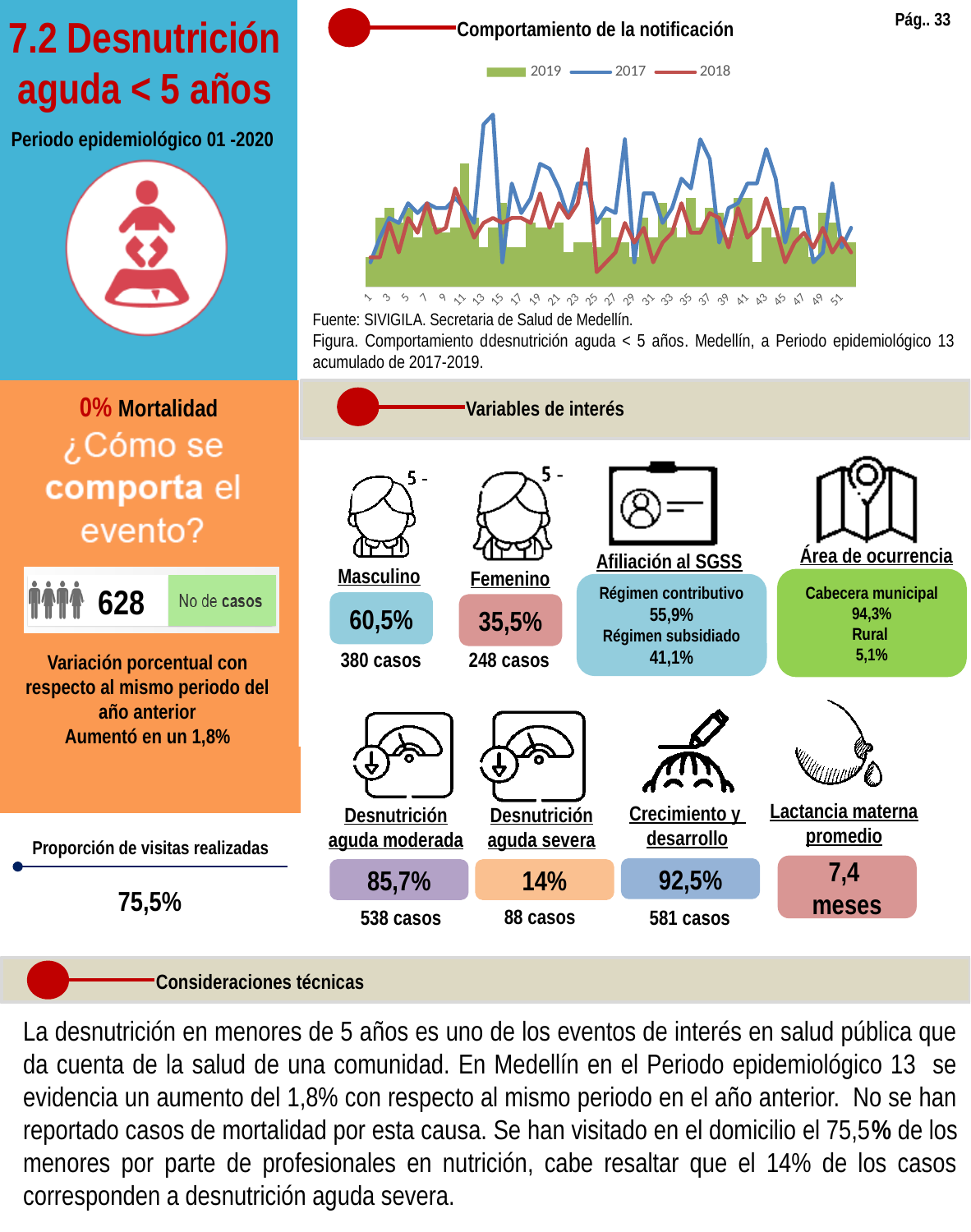
In the 'Comportamiento de la notificación' chart, at x = 13, which line is higher, 2017 or 2018? 2017 How many series does the legend of the 'Comportamiento de la notificación' chart list? 3 Which years are listed in the legend of the 'Comportamiento de la notificación' chart? 2019, 2017 and 2018 In the 'Comportamiento de la notificación' chart, at x = 25, which line is higher, 2017 or 2018? 2017 In the 'Comportamiento de la notificación' chart, which series reaches the highest peak? 2017 What kind of chart is 'Comportamiento de la notificación'? A combined bar and line chart In the 'Comportamiento de la notificación' chart, which series is drawn as bars rather than a line? 2019